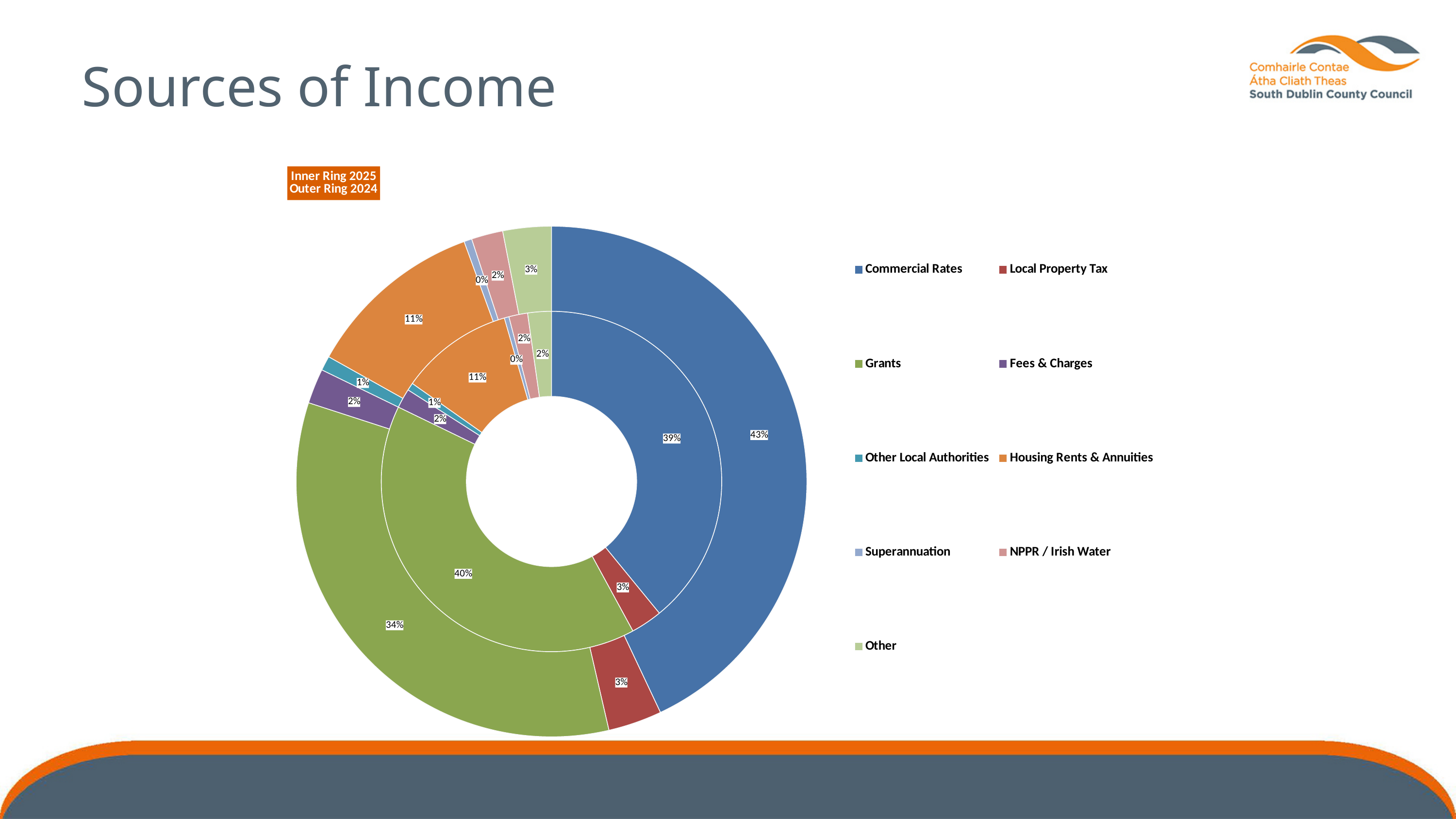
What is the difference between the Commercial Rates share in the outer ring (2024) and in the inner ring (2025)? 4% What share of income does Grants have in the inner ring (2025)? 40% What share of income does Grants have in the outer ring (2024)? 34% Which source of income has the smallest share in the inner ring (2025)? Superannuation In the inner ring (2025), which is larger: Grants or Commercial Rates? Grants What share of income does Commercial Rates have in the inner ring (2025)? 39% Which source of income has the largest share in the outer ring (2024)? Commercial Rates What share of income does Housing Rents & Annuities have in the outer ring (2024)? 11% Which year does the inner ring of the chart represent? 2025 What kind of chart is shown on the slide? Doughnut chart How many sources of income are listed in the legend? 9 What share of income does Commercial Rates have in the outer ring (2024)? 43%